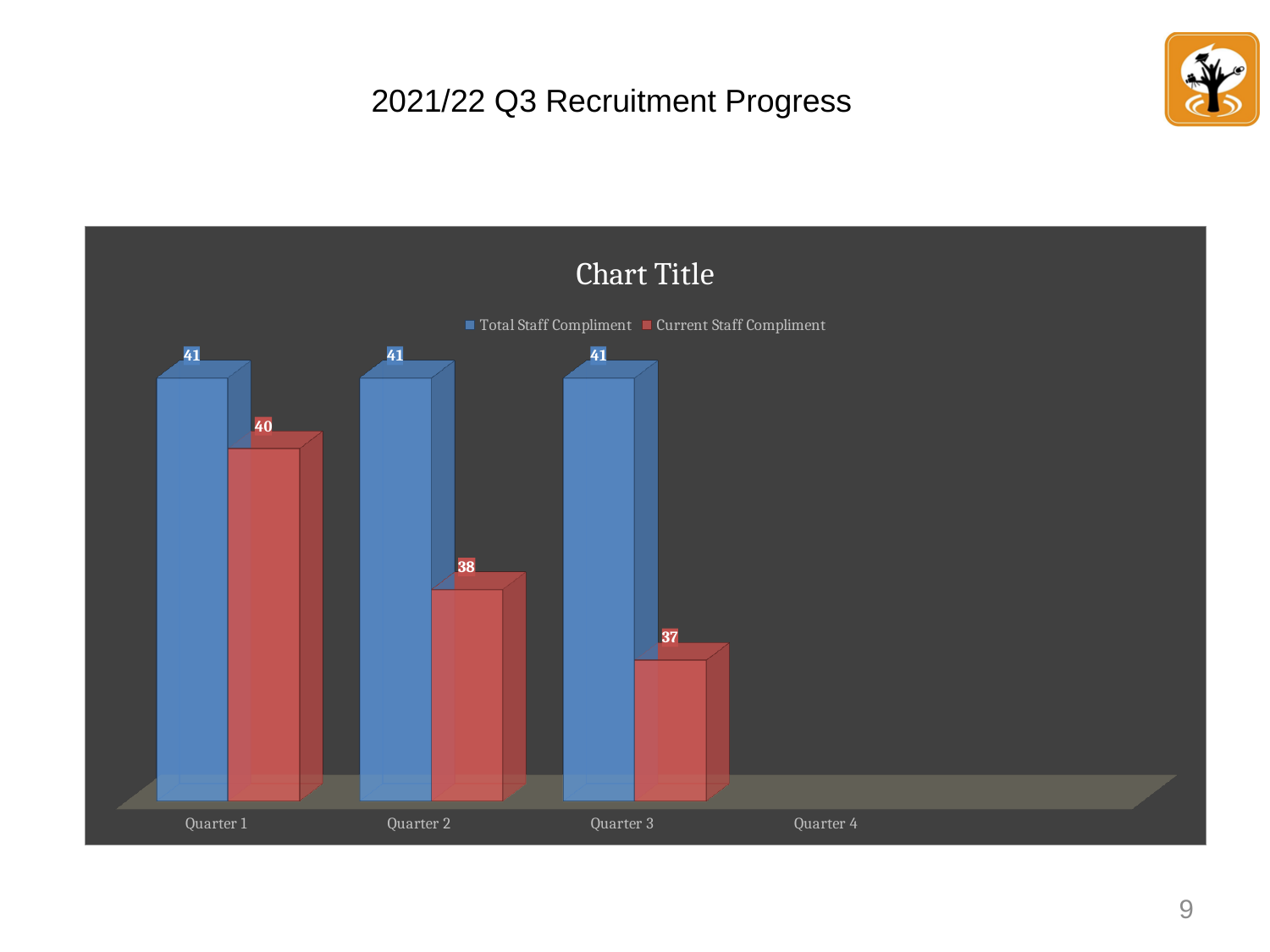
How many series does the legend list? 2 Which quarter has the lowest Current Staff Compliment value? Quarter 3 Which is larger in Quarter 2: Total Staff Compliment or Current Staff Compliment? Total Staff Compliment What is the value of Current Staff Compliment for Quarter 2? 38 What is the value of Total Staff Compliment for Quarter 1? 41 Which quarter has the highest Current Staff Compliment value? Quarter 1 What is the value of Current Staff Compliment for Quarter 3? 37 What is the difference between Total Staff Compliment and Current Staff Compliment in Quarter 3? 4 Does the Current Staff Compliment value rise or fall from Quarter 1 to Quarter 3? Fall What kind of chart is shown on the slide? Bar chart What is the value of Current Staff Compliment for Quarter 1? 40 What is the difference between Current Staff Compliment in Quarter 1 and Quarter 2? 2